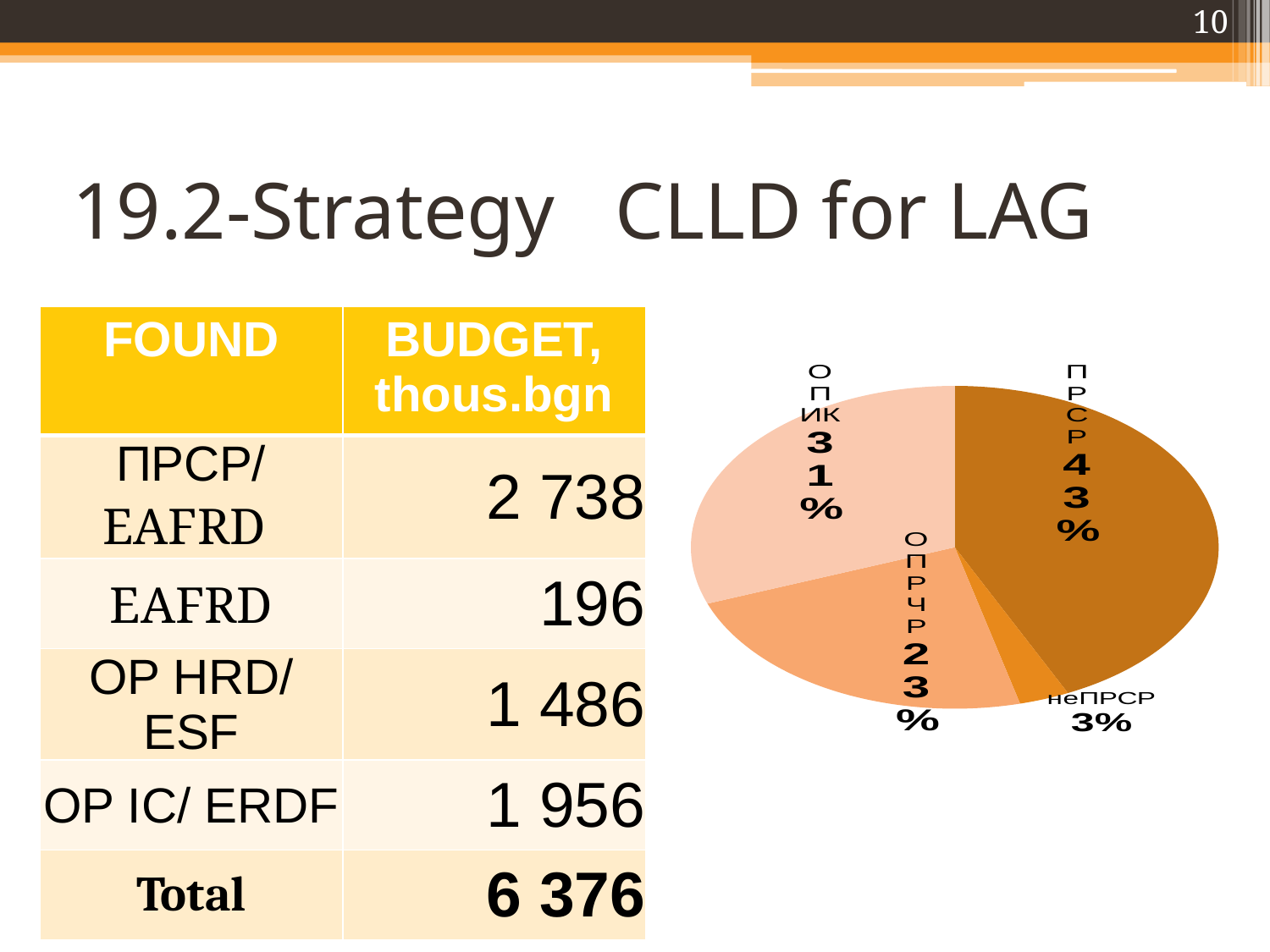
What share of the pie does ОПРЧР account for? 23% Which slice of the pie chart is the largest? ПРСР By how many percentage points does the ПРСР share exceed the ОПИК share? 12 Which slice of the pie chart is the smallest? неПРСР What kind of chart is shown on the slide? pie chart How many slices does the pie chart have? 4 By how many percentage points does the ОПРЧР share exceed the неПРСР share? 20 Which is larger in the pie chart, ОПИК or ОПРЧР? ОПИК What share of the pie does ПРСР account for? 43% Is the ПРСР slice greater or less than 40% of the pie? greater What share of the pie does неПРСР account for? 3%